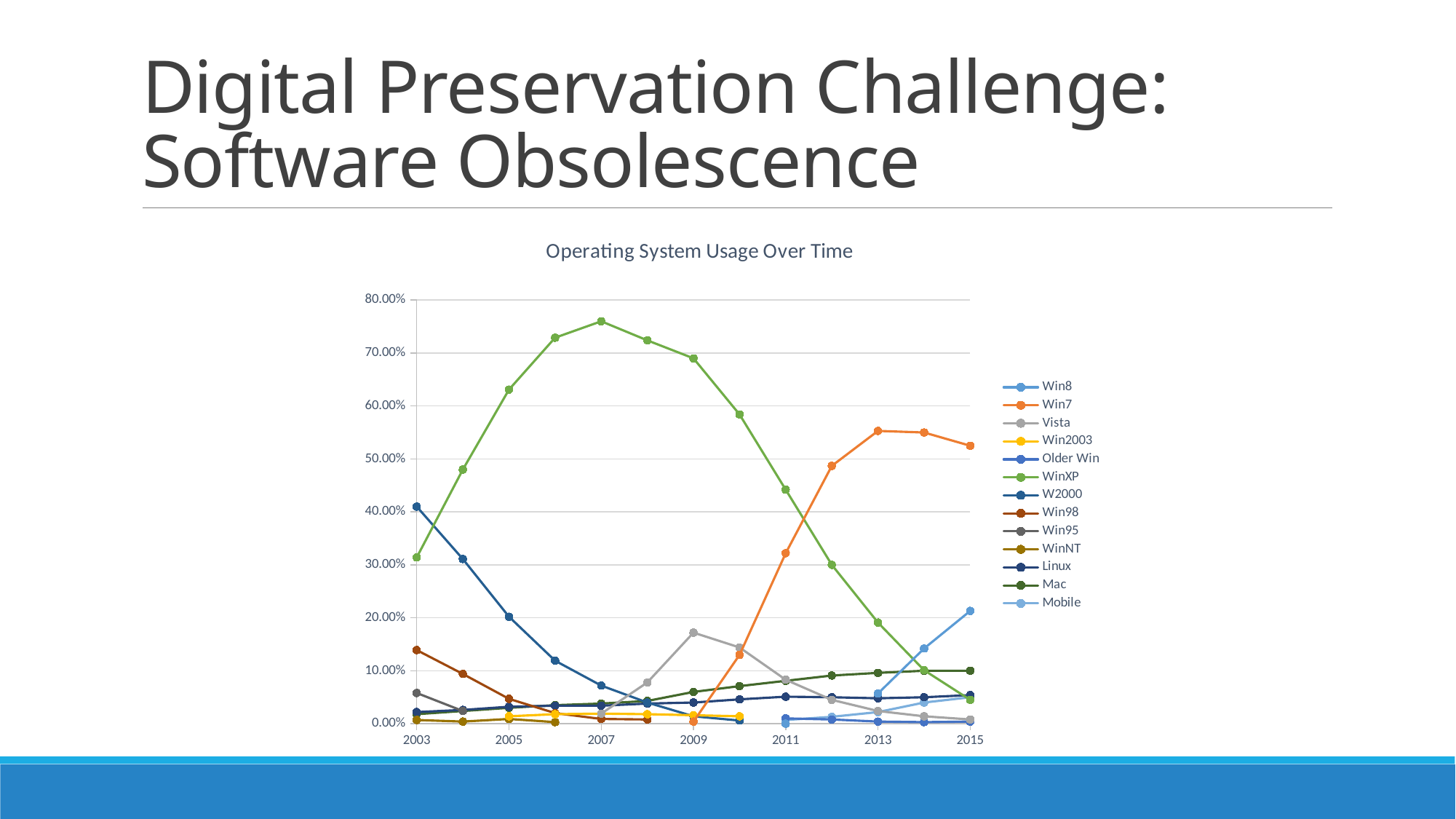
Which series reaches the highest value anywhere on the chart? WinXP Does the WinXP series rise or fall from 2007 to 2015? fall Is the value for WinXP in 2007 greater or less than 70.00%? greater Is the value for W2000 in 2003 greater or less than 50.00%? less How many series does the chart's legend list? 13 Is the value for Win8 in 2015 greater or less than 10.00%? greater What is the title of the chart? Operating System Usage Over Time In 2015, which is larger: Win7 or WinXP? Win7 What kind of chart is shown on the slide? line chart In which year does the WinXP series reach its peak? 2007 How many year labels are shown on the x axis? 7